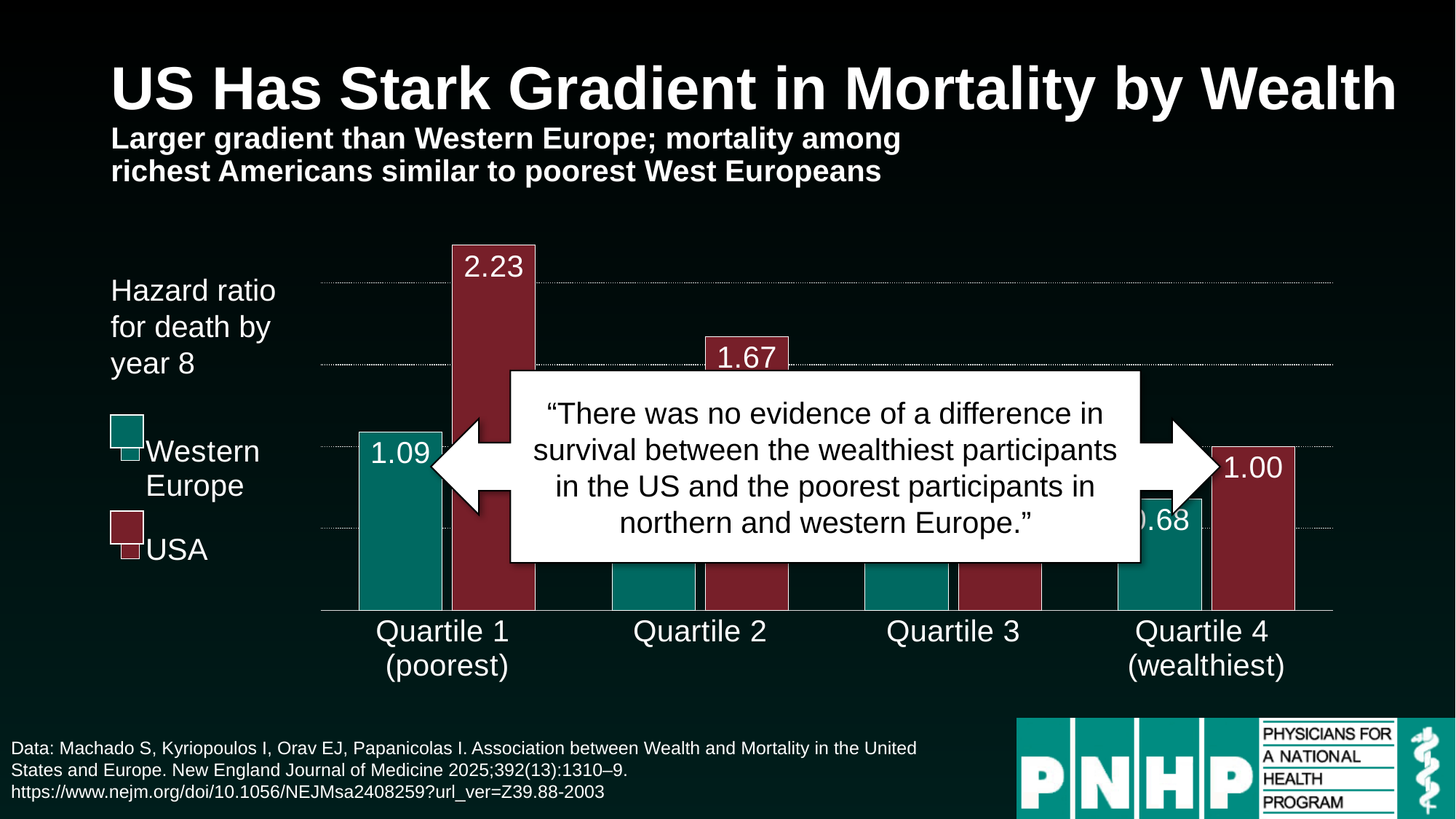
In which quartile is the USA hazard ratio highest? Quartile 1 (poorest) What is the hazard ratio for the USA in Quartile 4 (wealthiest)? 1.00 What is the hazard ratio for the USA in Quartile 1 (poorest)? 2.23 How many series does the legend list? 2 What is the hazard ratio for Western Europe in Quartile 1 (poorest)? 1.09 Do the USA hazard ratios rise or fall from Quartile 1 to Quartile 4? fall How many quartile categories are shown on the x axis? 4 What is the difference between the USA and Western Europe hazard ratios in Quartile 1 (poorest)? 1.14 In Quartile 1 (poorest), which series has the larger hazard ratio, Western Europe or USA? USA What does the y axis of the chart measure, according to the label on the left? Hazard ratio for death by year 8 What is the hazard ratio for the USA in Quartile 2? 1.67 What kind of chart is shown on the slide? bar chart